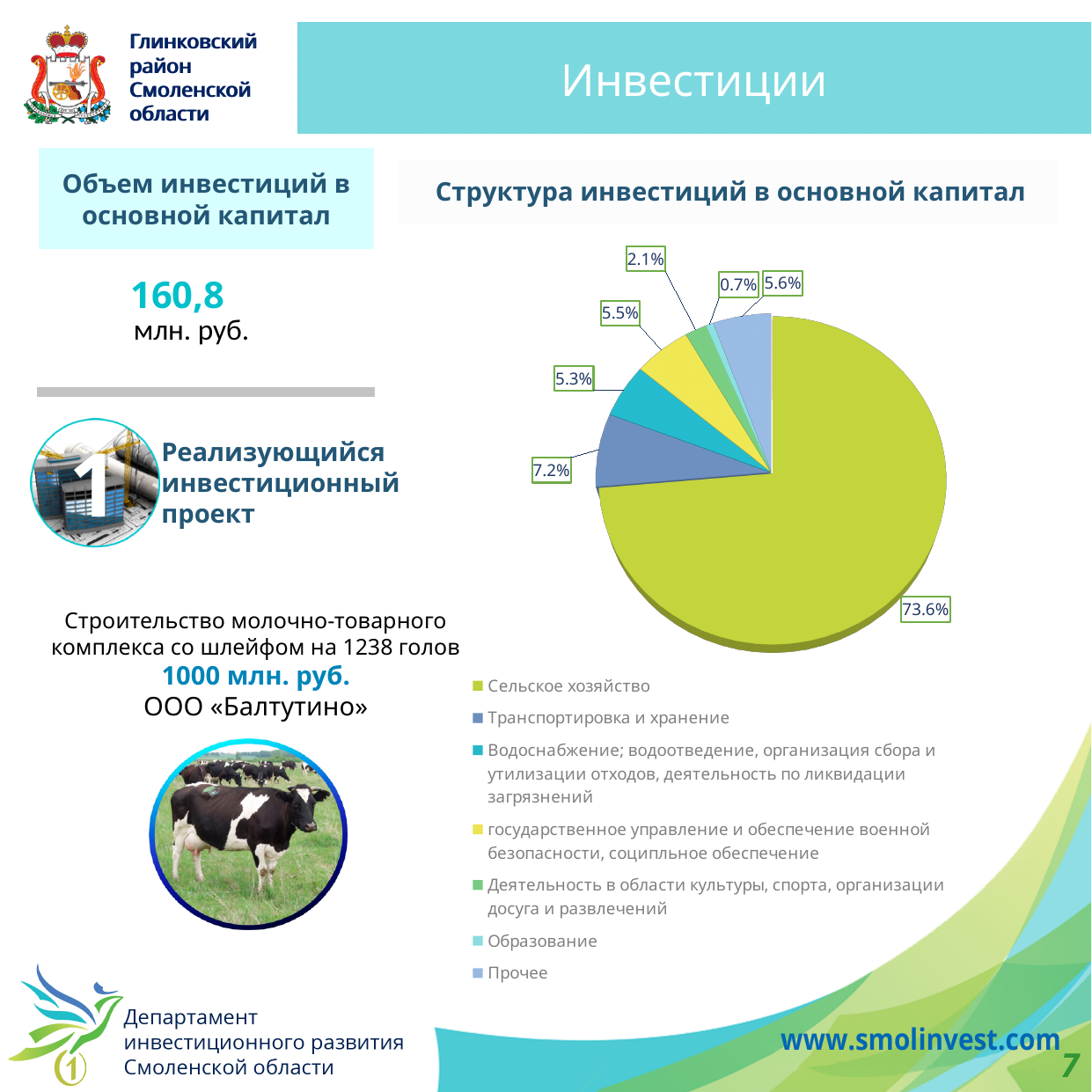
What kind of chart is shown under the title "Структура инвестиций в основной капитал"? pie chart Which slice is larger: "Транспортировка и хранение" or "Прочее"? Транспортировка и хранение Which category has the largest slice of the pie? Сельское хозяйство How many slices does the pie chart have? 7 What share of the pie does "Образование" have? 0.7% What is the title of the pie chart? Структура инвестиций в основной капитал What share of the pie does "Транспортировка и хранение" have? 7.2% What is the difference in percentage points between the "Сельское хозяйство" slice and the "Транспортировка и хранение" slice? 66.4 Which category has the smallest slice of the pie? Образование What share of the pie does "Сельское хозяйство" have? 73.6% What share of the pie does "Деятельность в области культуры, спорта, организации досуга и развлечений" have? 2.1% What share of the pie does "Прочее" have? 5.6%